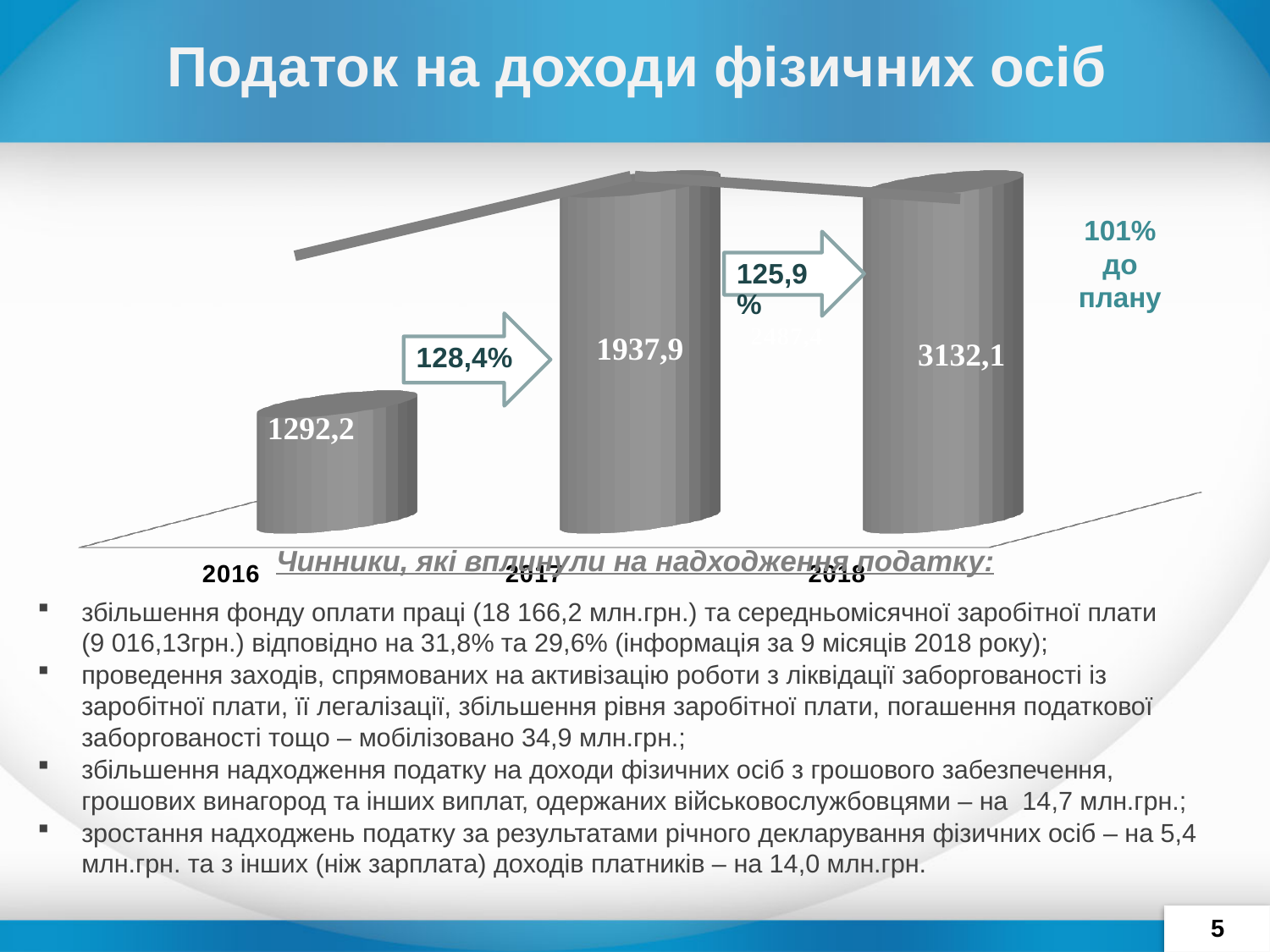
What is the value shown for 2017? 1937,9 What is the value shown for 2016? 1292,2 What is the difference between the values for 2017 and 2016? 645,7 Which is larger, the value for 2017 or the value for 2018? 2018 What is the value shown for 2018? 3132,1 Which year has the lowest value? 2016 What is the difference between the values for 2018 and 2017? 1194,2 What growth percentage is shown on the arrow between 2016 and 2017? 128,4% Which year has the highest value? 2018 What kind of chart is this? bar chart How many years are shown on the chart? 3 Do the values rise or fall from 2016 to 2018? rise